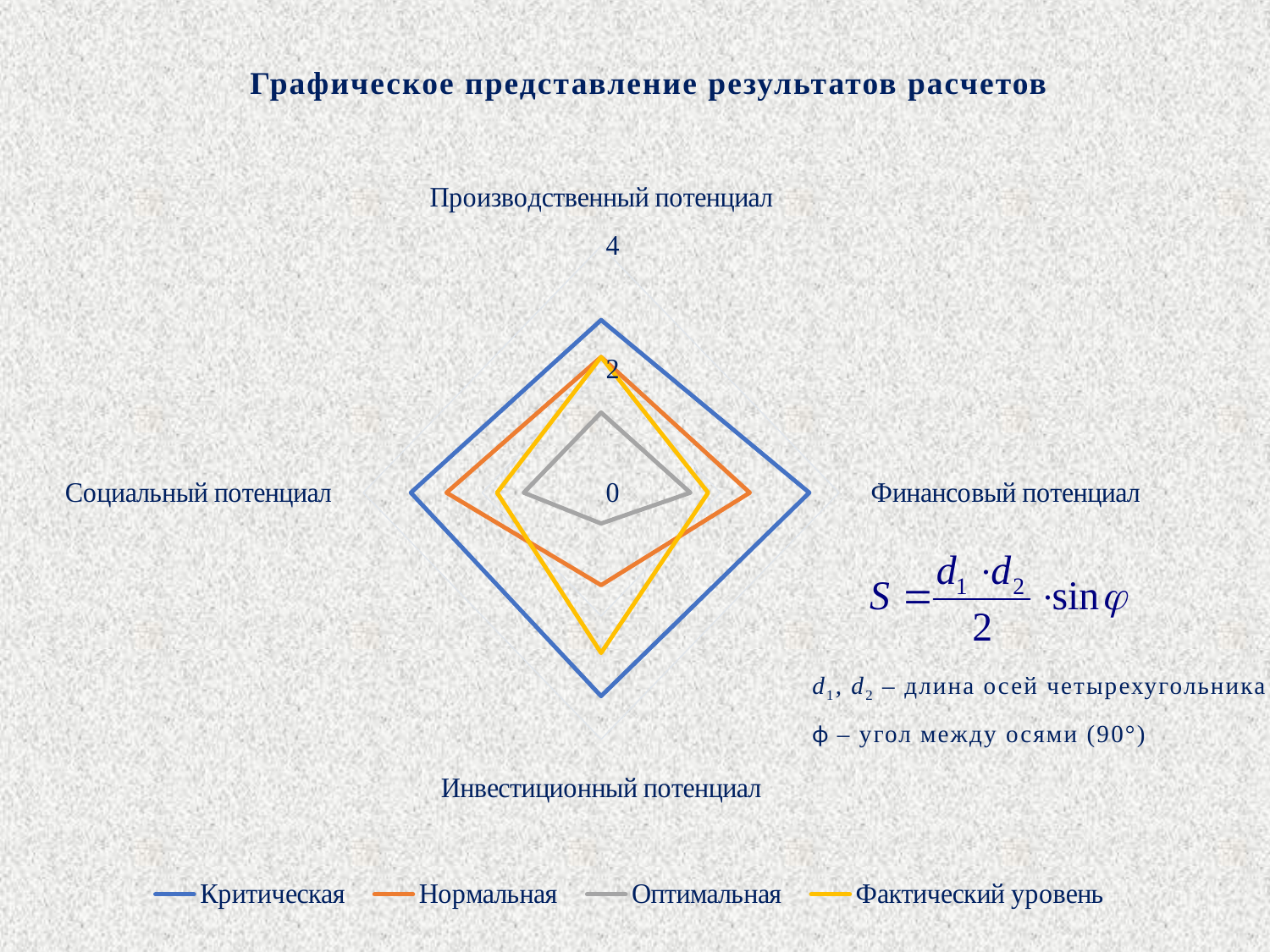
How many axes (categories) does the radar chart have? 4 On the Инвестиционный потенциал axis, which is larger: Фактический уровень or Нормальная? Фактический уровень What type of chart is shown on the slide? Radar chart Which series has the largest value on the Производственный потенциал axis? Критическая What is the title of the slide containing the chart? Графическое представление результатов расчетов How many series does the legend list? 4 On the Социальный потенциал axis, which is larger: Нормальная or Фактический уровень? Нормальная Is the value of Критическая on the Производственный потенциал axis greater or less than 2? greater Is the value of Оптимальная on the Производственный потенциал axis greater or less than 4? less Which series has the smallest value on the Инвестиционный потенциал axis? Оптимальная Which series is drawn in yellow according to the legend? Фактический уровень Is the value of Фактический уровень on the Инвестиционный потенциал axis greater or less than 2? greater